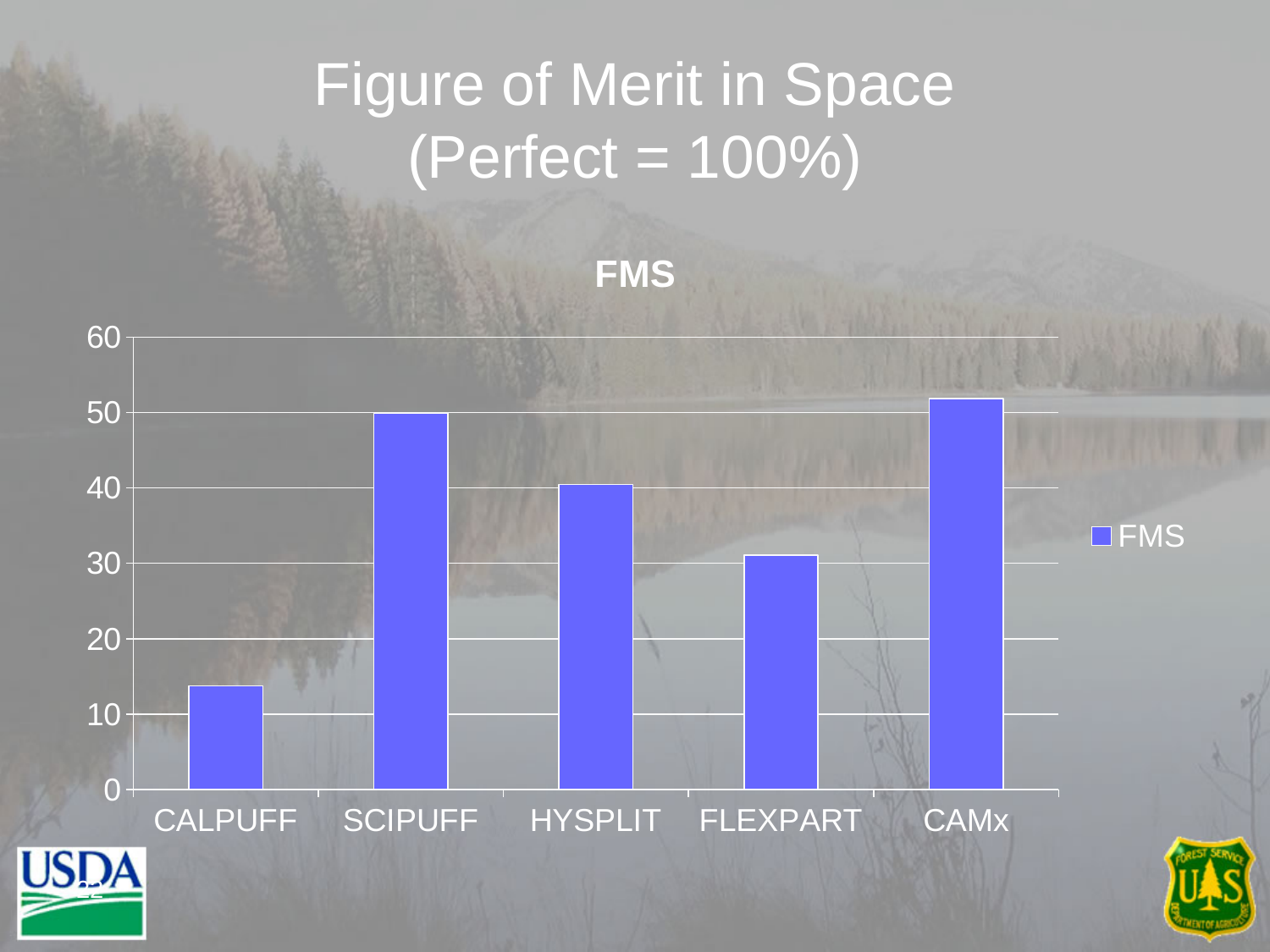
How many categories are shown on the x axis of the FMS chart? 5 Is the FMS value for SCIPUFF greater or less than 40? greater Is the FMS value for CAMx greater or less than 50? greater Which has a larger FMS value, HYSPLIT or FLEXPART? HYSPLIT How many series does the legend of the FMS chart list? 1 What kind of chart is shown on the slide? bar chart What is the title of the chart on the slide? FMS Is the FMS value for CALPUFF greater or less than 20? less Which category has the highest FMS value? CAMx Which category has the lowest FMS value? CALPUFF